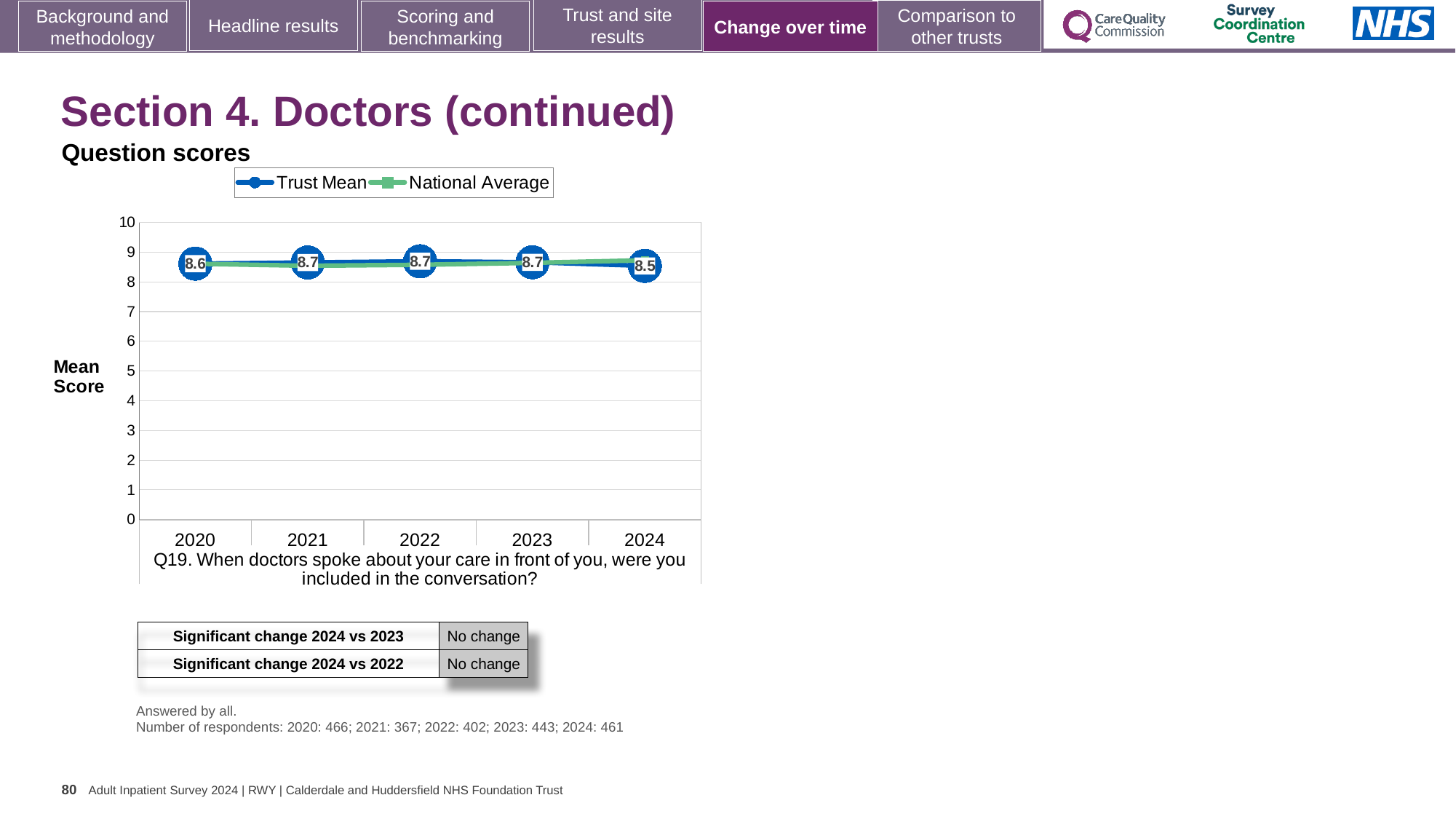
What is the Trust Mean score for 2022? 8.7 How many series does the legend list? 2 What is the label on the y axis of the chart? Mean Score In which year is the Trust Mean score lowest? 2024 What kind of chart is shown? Line chart What is the Trust Mean score for 2020? 8.6 What is the Trust Mean score for 2024? 8.5 Which year has the larger Trust Mean score, 2021 or 2024? 2021 What is the difference between the Trust Mean scores for 2023 and 2024? 0.2 Is the National Average value for 2024 greater or less than 8? greater Does the Trust Mean rise or fall from 2023 to 2024? Fall How many years are plotted on the x axis? 5